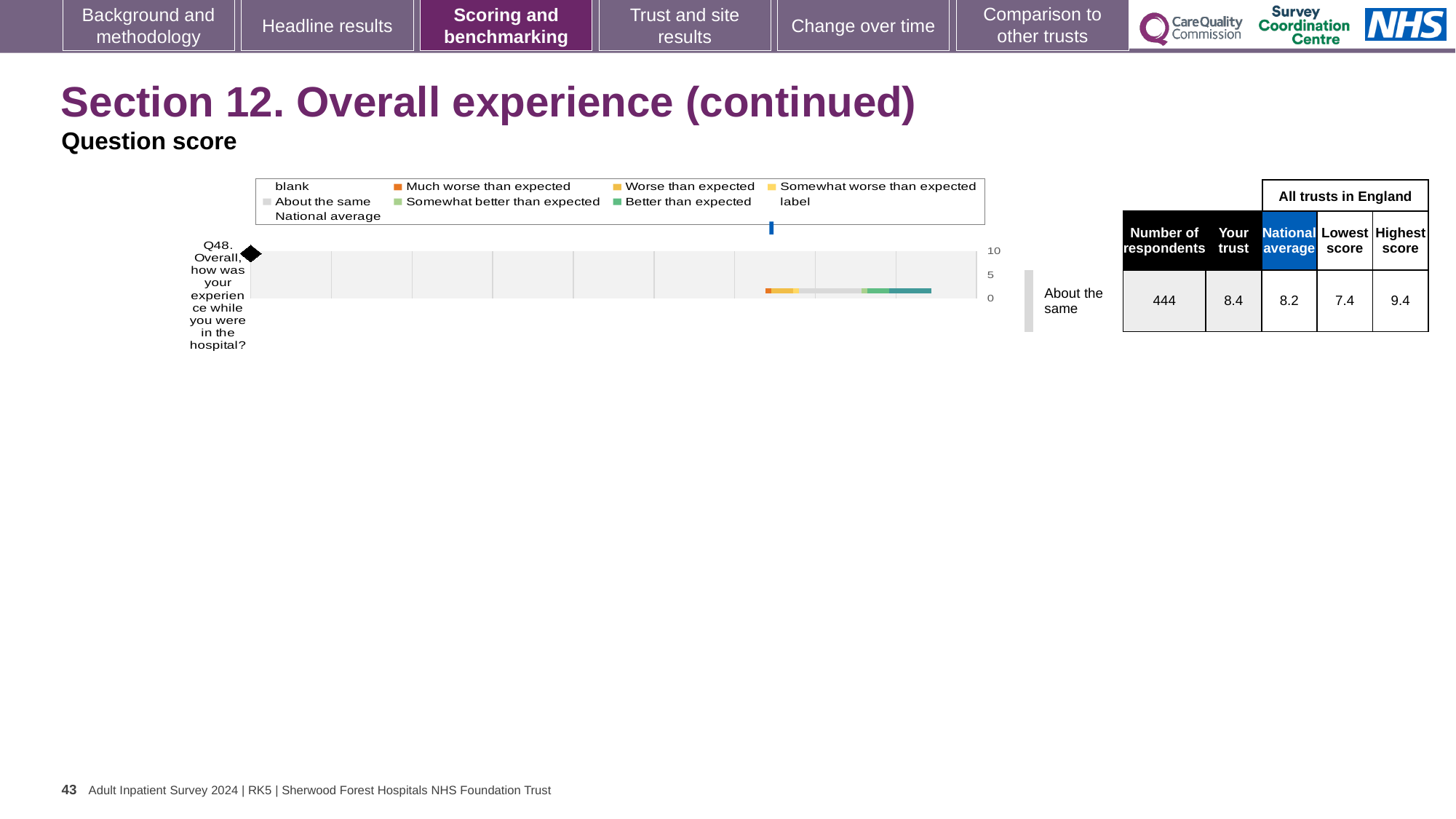
By how much does the trust's score for Q48 exceed the national average? 0.2 What is the maximum value shown on the chart's score axis? 10 What is the highest score among all trusts in England for Q48? 9.4 What is the difference between the highest and lowest scores for Q48 across all trusts in England? 2.0 What benchmark category is the trust's Q48 score placed in? About the same How many questions are plotted on the chart? 1 What is the lowest score among all trusts in England for Q48? 7.4 How many respondents answered Q48? 444 What is the 'Your trust' score for Q48 (Overall, how was your experience while you were in the hospital?)? 8.4 What is the national average score for Q48? 8.2 Which is higher for Q48: the trust's score or the national average? Your trust What kind of chart is used to show the Q48 question score? bar chart